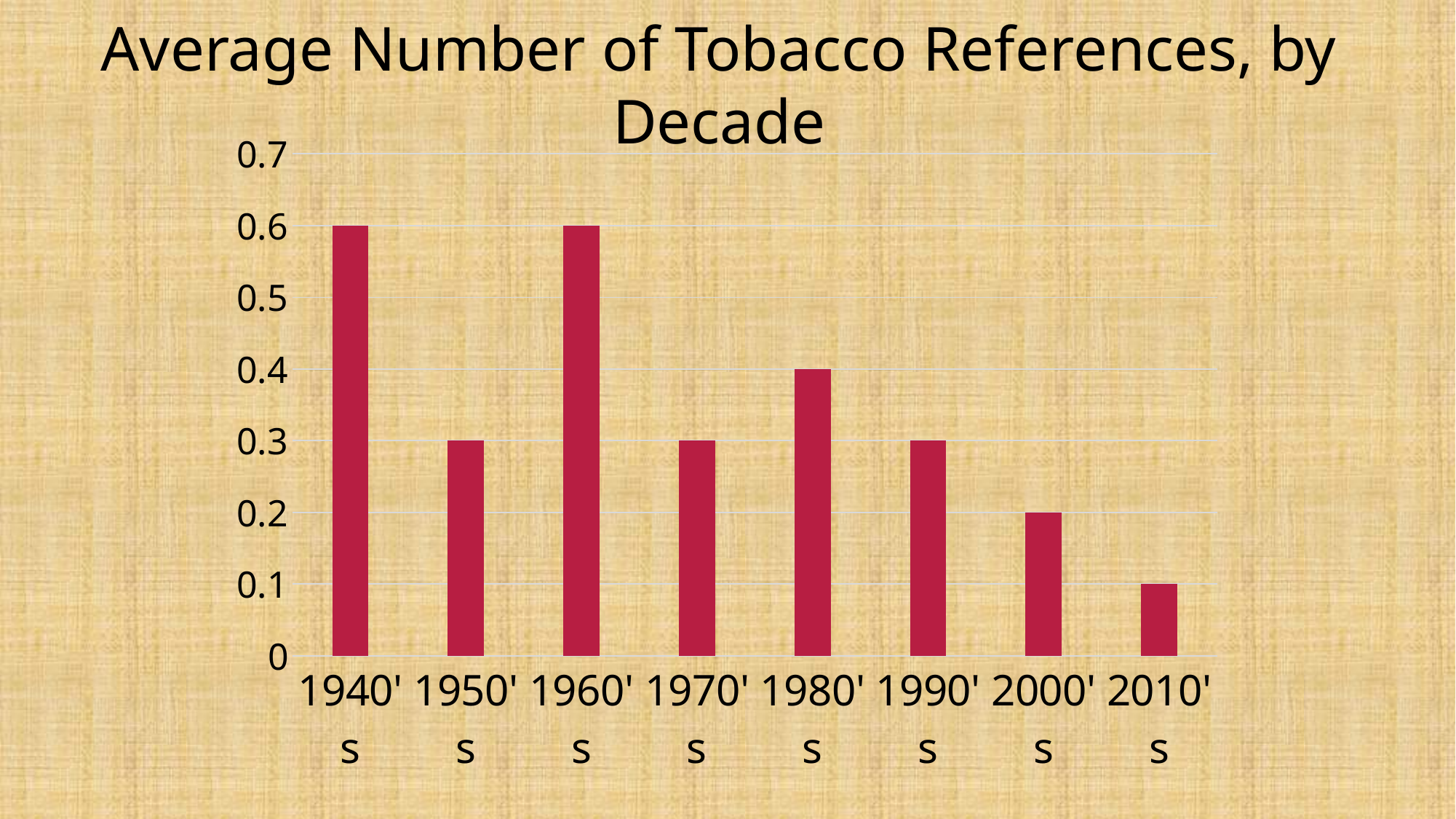
What is the value for the 1950's? 0.3 Which decade has the lowest value? 2010's What is the difference between the values for the 1980's and the 2010's? 0.3 What is the title of the chart? Average Number of Tobacco References, by Decade How many decades are shown on the x axis? 8 What is the value for the 2000's? 0.2 Do the values generally rise or fall from the 1960's to the 2010's? fall What kind of chart is shown on the slide? bar chart Which is larger, the value for the 1940's or the value for the 1990's? 1940's Is the value for the 1980's greater or less than 0.5? less What is the value for the 1980's? 0.4 What is the difference between the values for the 1960's and the 1970's? 0.3